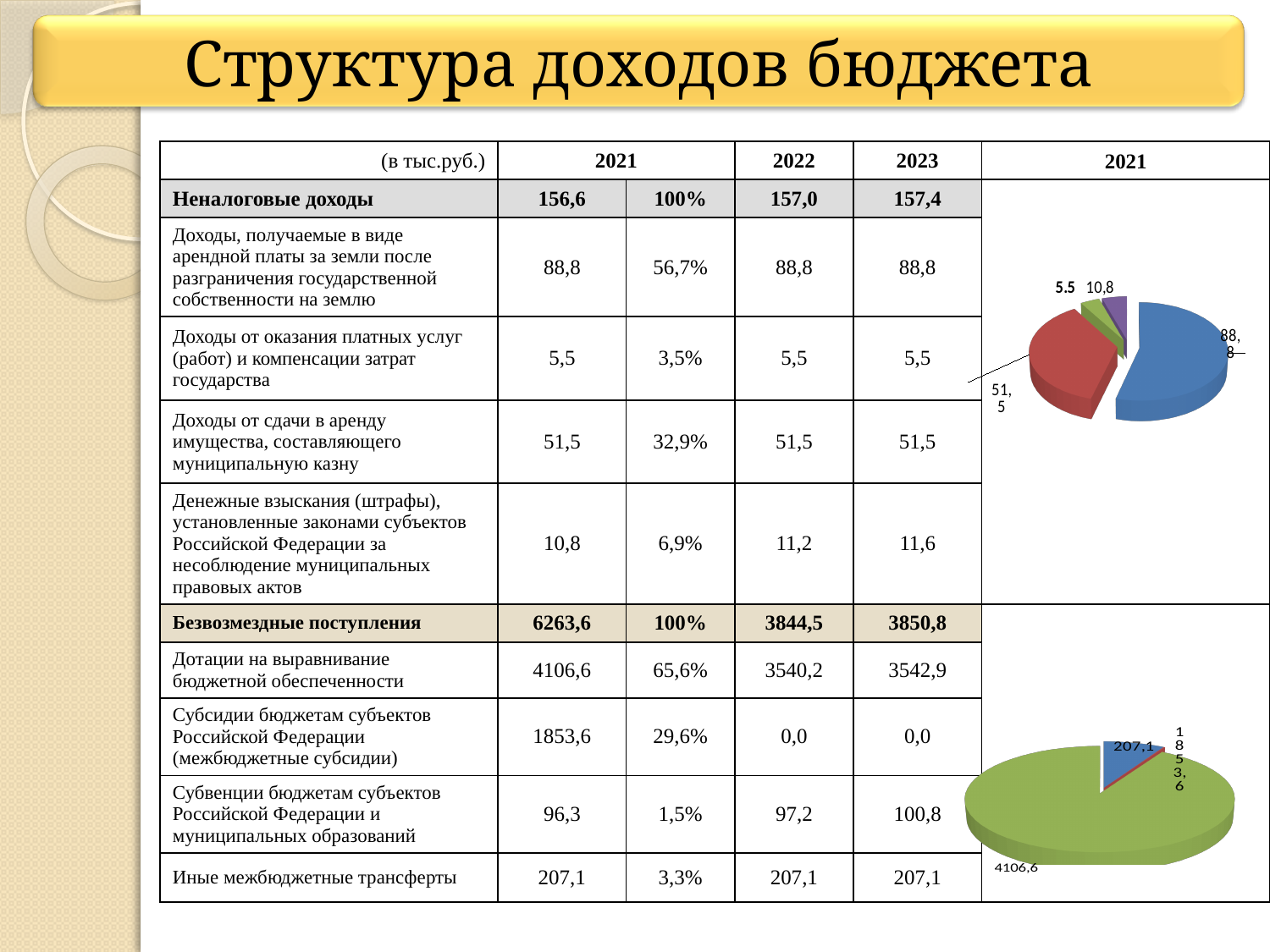
What colour is the largest slice in the bottom pie chart? green In the top pie chart, what is the value of the smallest slice? 5.5 What colour is the largest slice in the top pie chart? blue In the top pie chart, what is the difference between the 88,8 slice and the 51,5 slice? 37,3 In the top pie chart, which slice is larger: the one labelled 10,8 or the one labelled 5.5? 10,8 What type of chart is the bottom chart on the right side of the slide? pie chart What type of chart is the top chart on the right side of the slide? pie chart In the bottom pie chart, what is the difference between the 4106,6 slice and the 1853,6 slice? 2253,0 In the bottom pie chart, what is the value of the largest slice? 4106,6 How many slices does the top pie chart have? 4 In the top pie chart, what is the value of the largest slice? 88,8